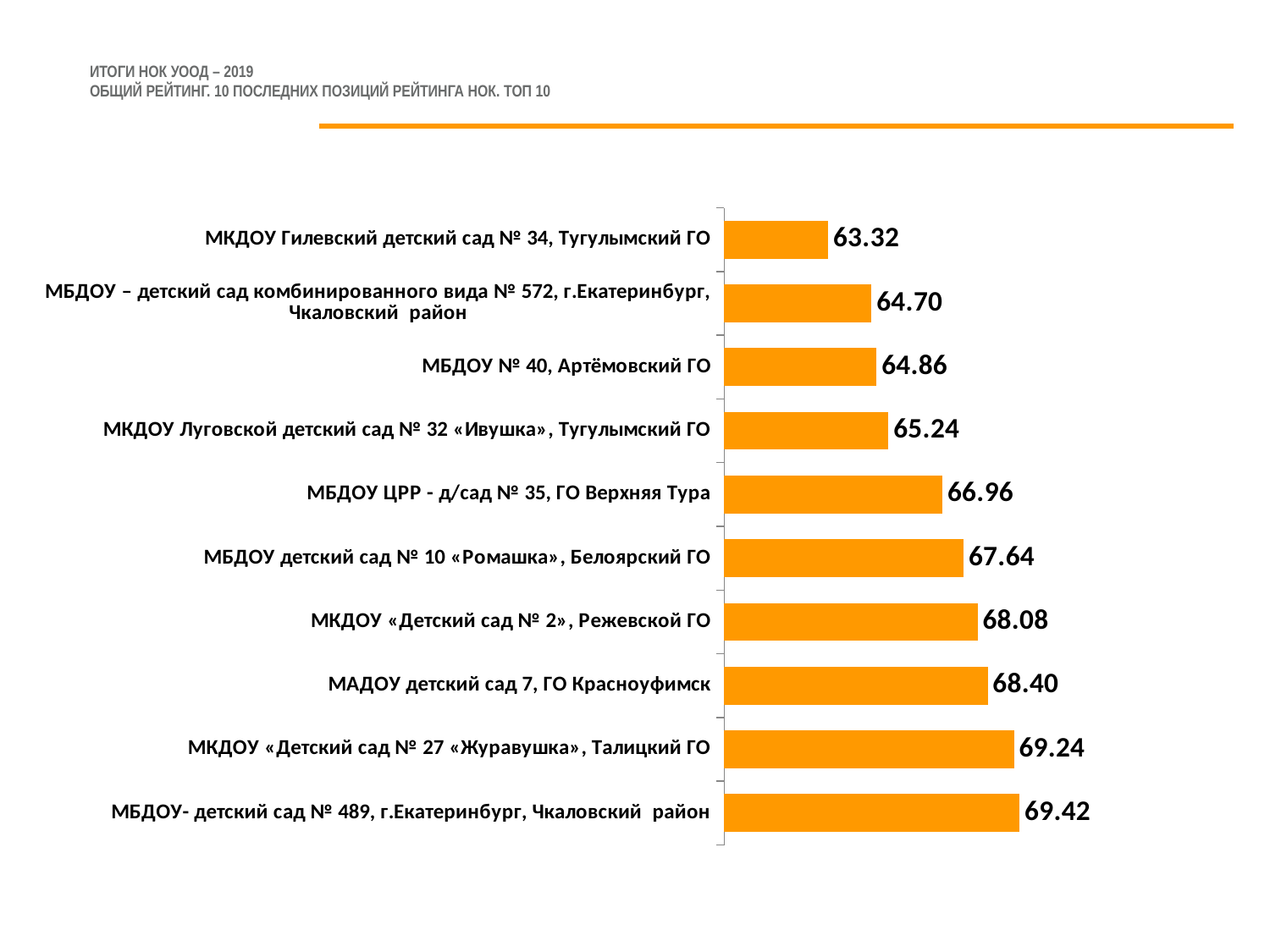
What is the value for МКДОУ «Детский сад № 2», Режевской ГО? 68.08 What is the value for МБДОУ ЦРР - д/сад № 35, ГО Верхняя Тура? 66.96 Which category has the highest value? МБДОУ- детский сад № 489, г.Екатеринбург, Чкаловский район What is the difference between the values for МБДОУ- детский сад № 489, г.Екатеринбург, Чкаловский район and МКДОУ Гилевский детский сад № 34, Тугулымский ГО? 6.10 What is the value for МАДОУ детский сад 7, ГО Красноуфимск? 68.40 What colour are the bars in the chart? Orange How many categories are shown in the chart? 10 What is the value for МБДОУ № 40, Артёмовский ГО? 64.86 What kind of chart is shown on the slide? Bar chart Which category has the lowest value? МКДОУ Гилевский детский сад № 34, Тугулымский ГО What is the difference between the values for МБДОУ ЦРР - д/сад № 35, ГО Верхняя Тура and МКДОУ Луговской детский сад № 32 «Ивушка», Тугулымский ГО? 1.72 Which has a larger value: МБДОУ детский сад № 10 «Ромашка», Белоярский ГО or МБДОУ № 40, Артёмовский ГО? МБДОУ детский сад № 10 «Ромашка», Белоярский ГО